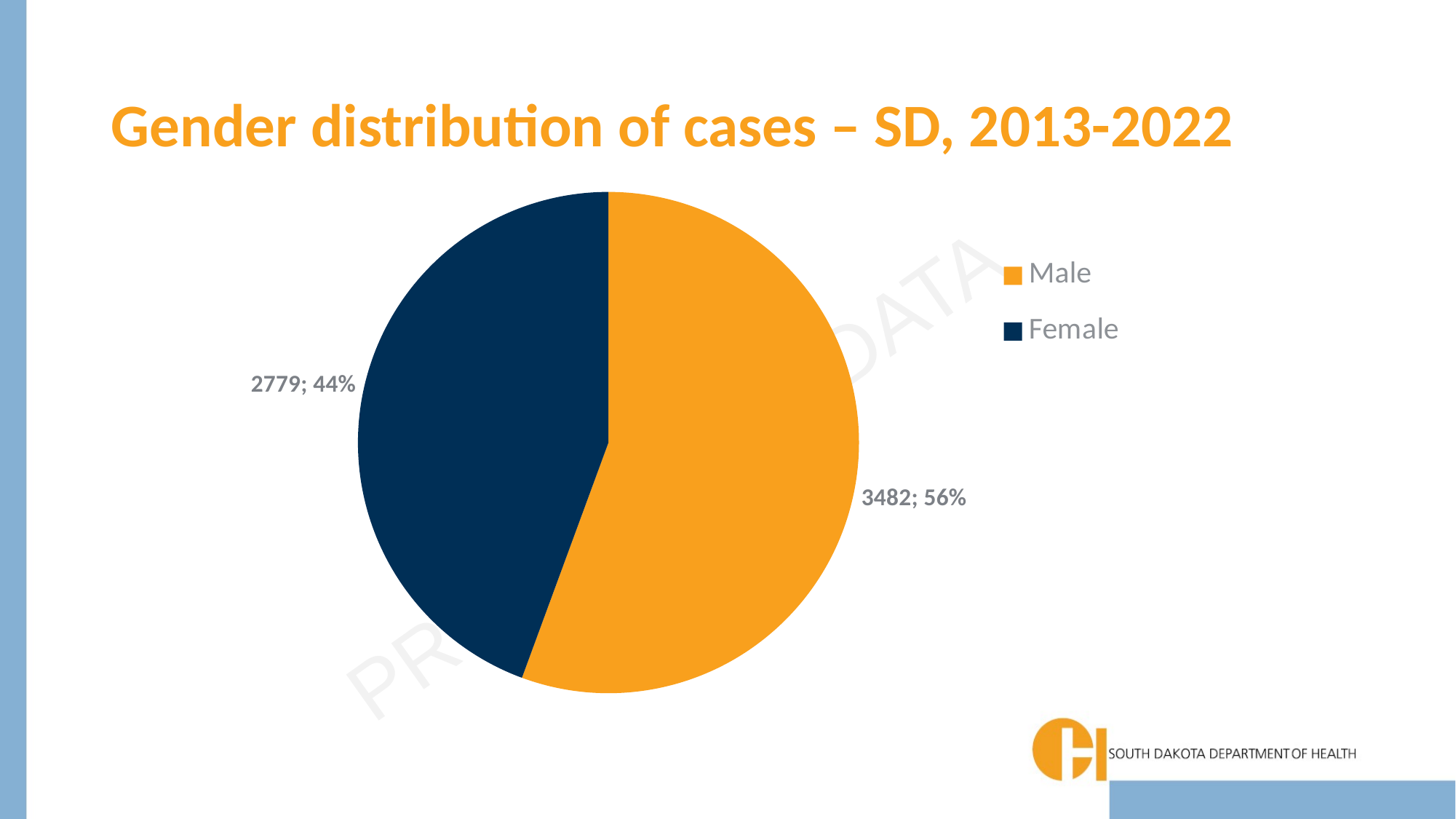
What kind of chart is shown on the slide? pie chart What share of the pie does the Female slice represent? 44% Is the number of Male cases larger or smaller than the number of Female cases? larger What is the difference in the number of cases between Male and Female? 703 What colour is the Female slice in the pie chart? dark navy blue What share of the pie does the Male slice represent? 56% What is the total number of cases across both slices? 6261 How many cases are shown for Male? 3482 How many cases are shown for Female? 2779 How many slices does the pie chart have? 2 Which gender has the larger slice of the pie? Male Which gender has the smaller slice of the pie? Female